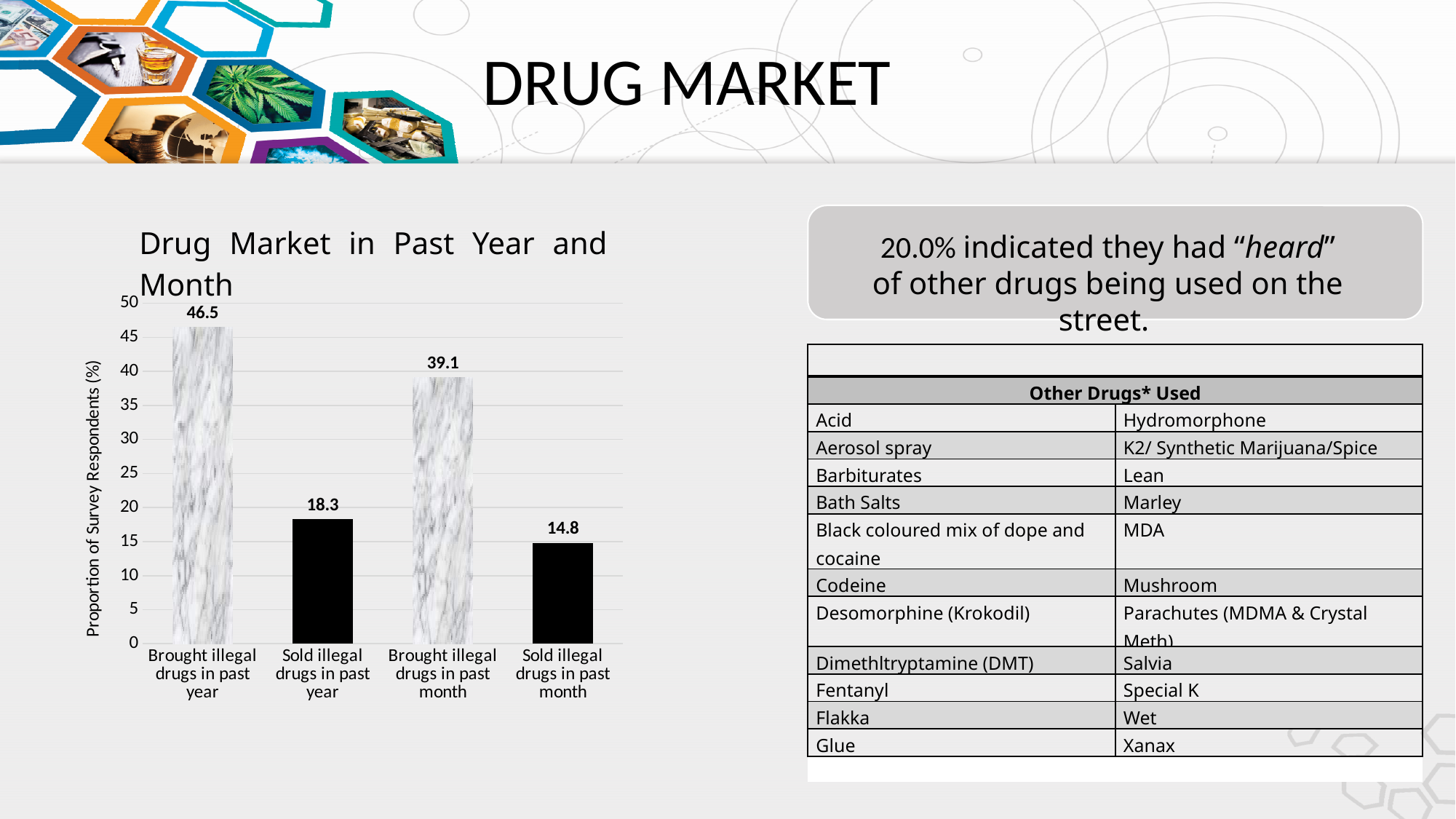
Which category has the highest value? Brought illegal drugs in past year What is the difference between 'Brought illegal drugs in past year' and 'Sold illegal drugs in past year'? 28.2 What kind of chart is shown? bar chart Which is larger: 'Brought illegal drugs in past month' or 'Sold illegal drugs in past year'? Brought illegal drugs in past month Is the value for 'Brought illegal drugs in past month' greater or less than 35? greater What is the difference between 'Sold illegal drugs in past year' and 'Sold illegal drugs in past month'? 3.5 What is the label of the y axis? Proportion of Survey Respondents (%) What is the value for 'Sold illegal drugs in past month'? 14.8 What is the value for 'Brought illegal drugs in past month'? 39.1 How many categories are shown on the chart? 4 What is the value for 'Brought illegal drugs in past year'? 46.5 Which category has the lowest value? Sold illegal drugs in past month